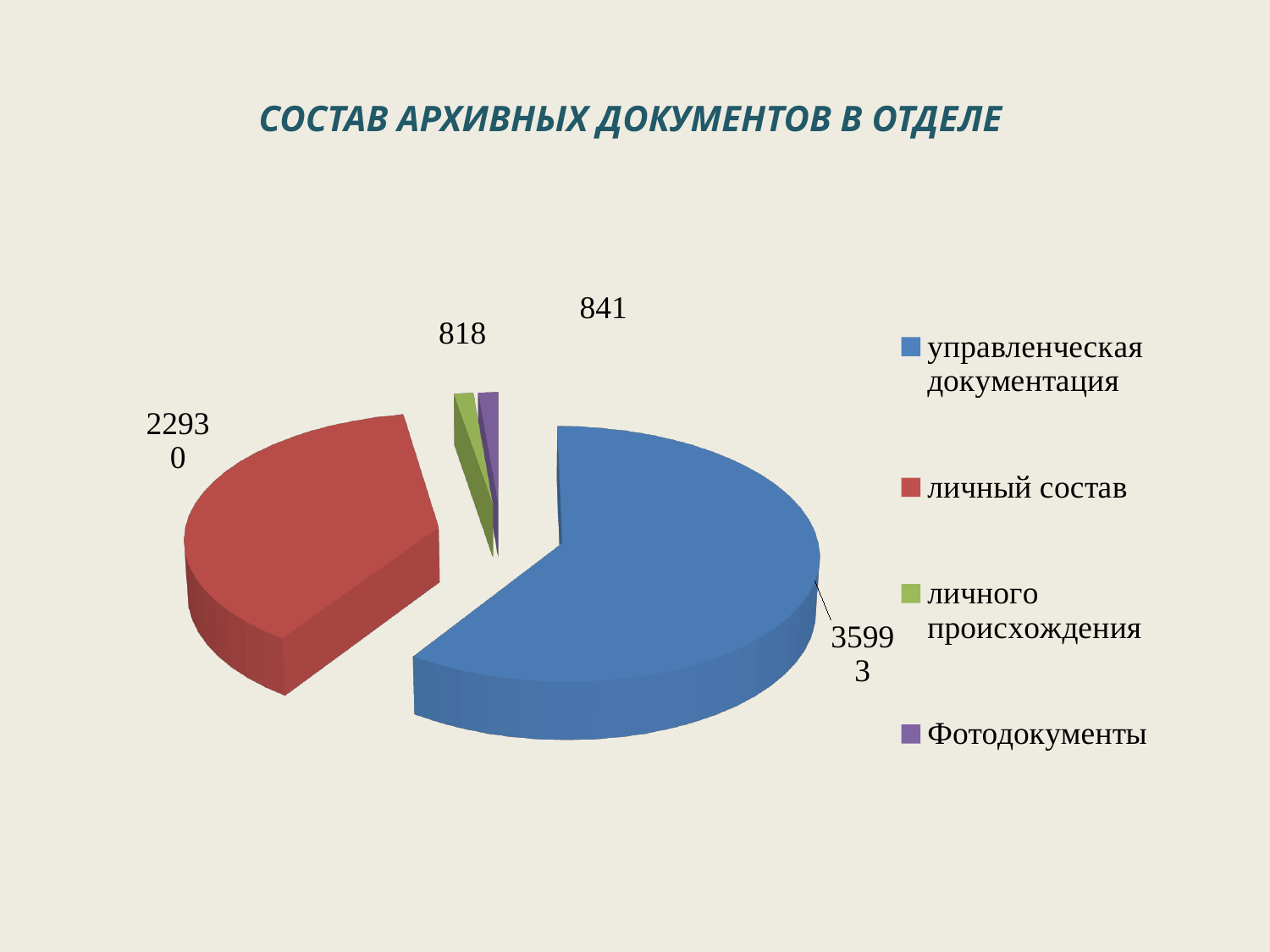
Which is larger, the value for Фотодокументы or the value for личного происхождения? Фотодокументы How many categories does the pie chart show? 4 What type of chart is shown on the slide? pie chart Which category has the largest slice? управленческая документация Which category has the smallest value? личного происхождения What is the value for личный состав? 22930 What is the title of the chart? СОСТАВ АРХИВНЫХ ДОКУМЕНТОВ В ОТДЕЛЕ What is the difference between the values for управленческая документация and личный состав? 13063 Which colour represents личный состав in the legend? red What is the value for личного происхождения? 818 What is the value for управленческая документация? 35993 What is the value for Фотодокументы? 841